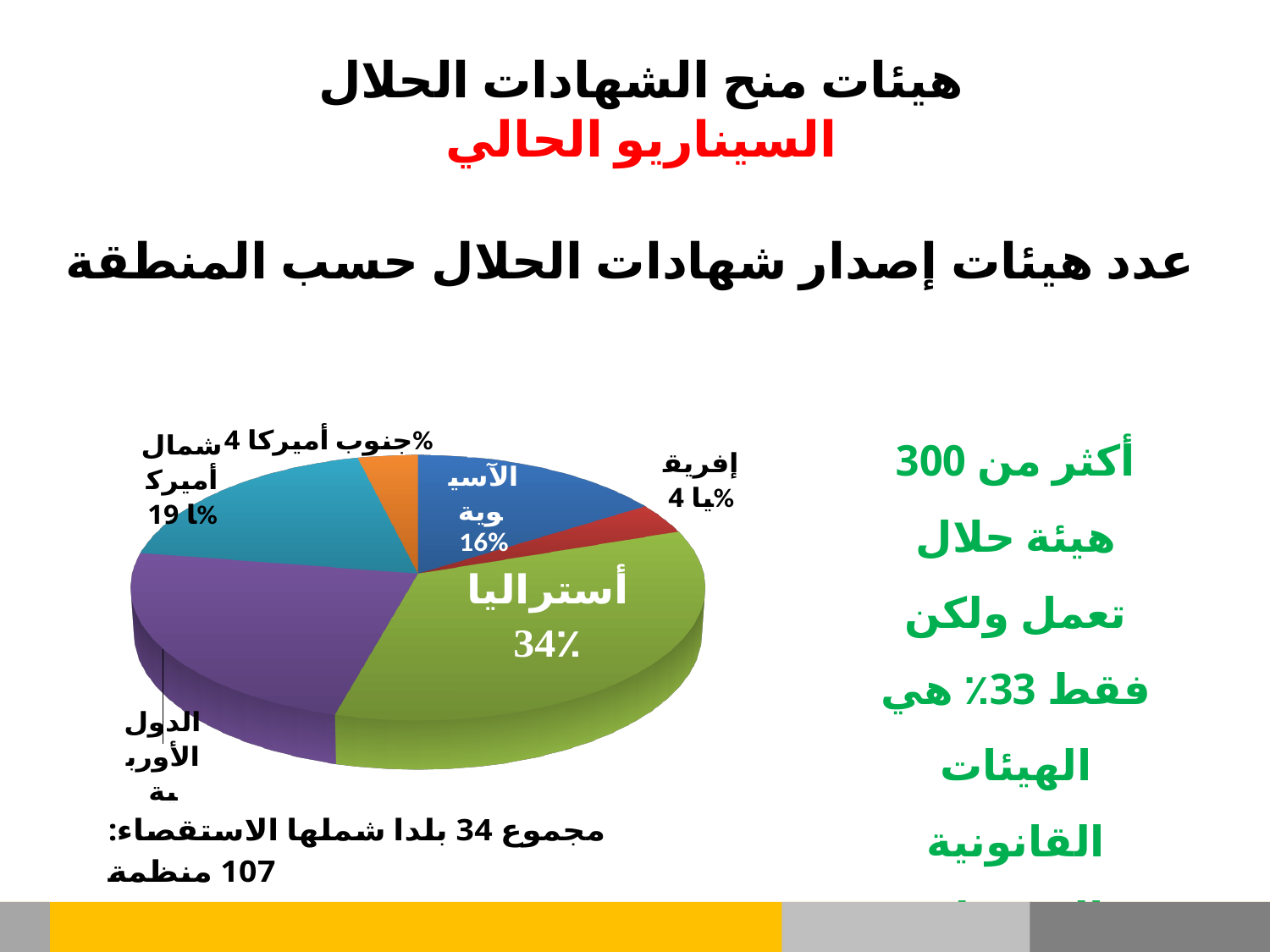
According to the note below the chart, how many countries were covered by the survey? 34 Which region has the largest slice of the pie? أستراليا What percentage is shown for إفريقيا? 4% What percentage is shown for جنوب أميركا? 4% What percentage is shown for the الآسيوية slice? 16% What percentage is shown for شمال أميركا? 19% What percentage of the pie does أستراليا account for? 34% By how many percentage points does أستراليا exceed الآسيوية? 18 Which slice is larger, شمال أميركا or الآسيوية? شمال أميركا By how many percentage points does شمال أميركا exceed إفريقيا? 15 How many slices does the pie chart have? 6 What kind of chart is shown on the slide? pie chart